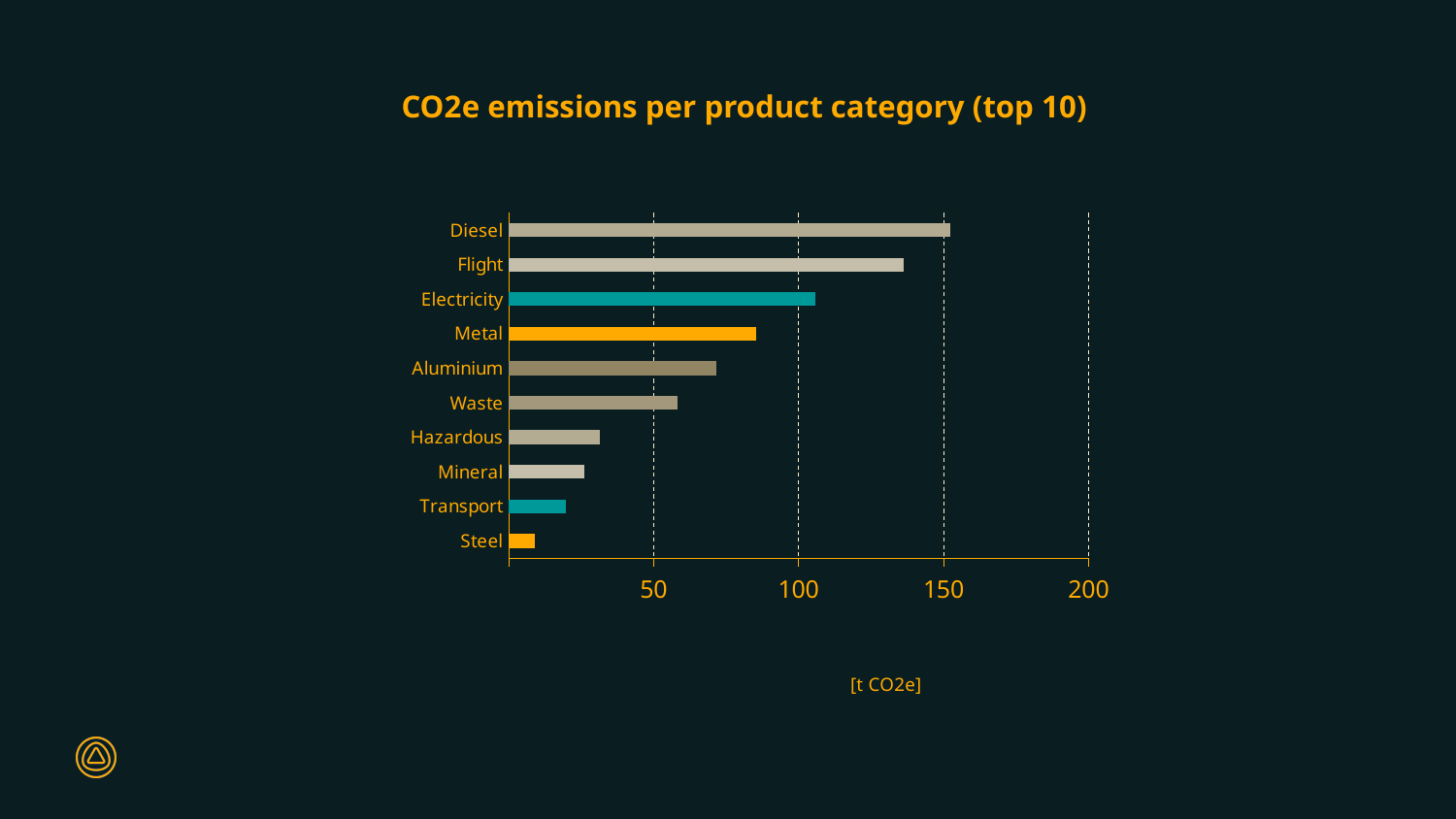
Which product category has the lowest CO2e emissions? Steel What kind of chart is shown on the slide? bar chart How many product categories are shown in the chart? 10 Is the value for Electricity greater or less than 100? greater What is the title of the chart? CO2e emissions per product category (top 10) Which has higher CO2e emissions, Flight or Electricity? Flight Is the value for Hazardous greater or less than 50? less Which has higher CO2e emissions, Waste or Aluminium? Aluminium What unit is shown for the horizontal axis? [t CO2e] Is the value for Metal greater or less than 100? less Which product category has the highest CO2e emissions? Diesel